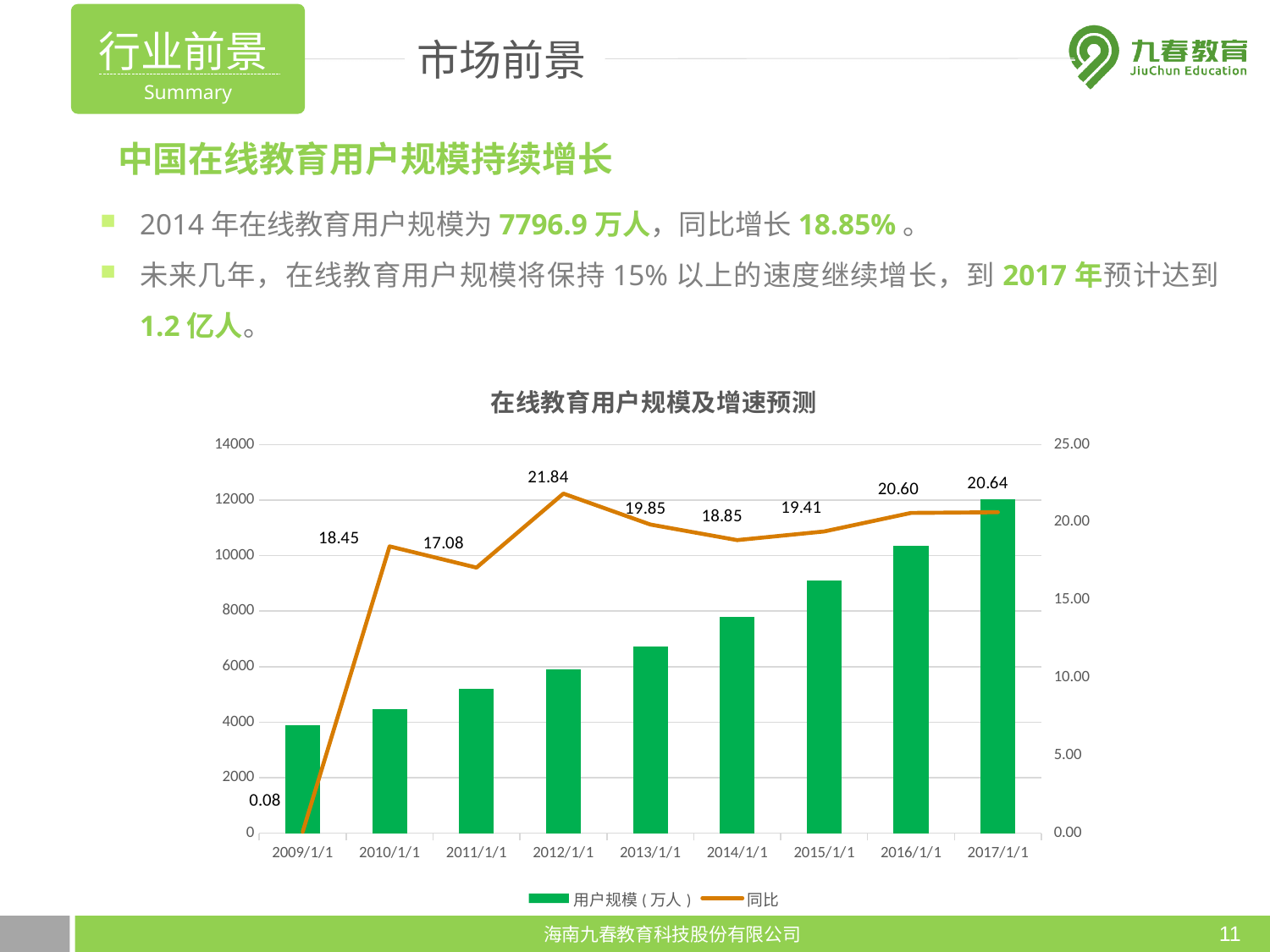
What is the difference between the 同比 values for 2012/1/1 and 2011/1/1? 4.76 Which year has the highest 同比 value? 2012/1/1 How many years are shown on the x axis of the chart? 9 What is the 同比 value for 2012/1/1? 21.84 How many series does the chart legend list? 2 Which year has the lowest 同比 value? 2009/1/1 Is the 用户规模 (万人) value for 2013/1/1 greater or less than 6000? greater What is the 同比 value for 2014/1/1? 18.85 Do the 用户规模 (万人) bars rise or fall from 2009/1/1 to 2017/1/1? rise What is the 同比 value for 2017/1/1? 20.64 Is the 用户规模 (万人) value for 2017/1/1 greater or less than 10000? greater Which year has a larger 同比 value, 2013/1/1 or 2014/1/1? 2013/1/1